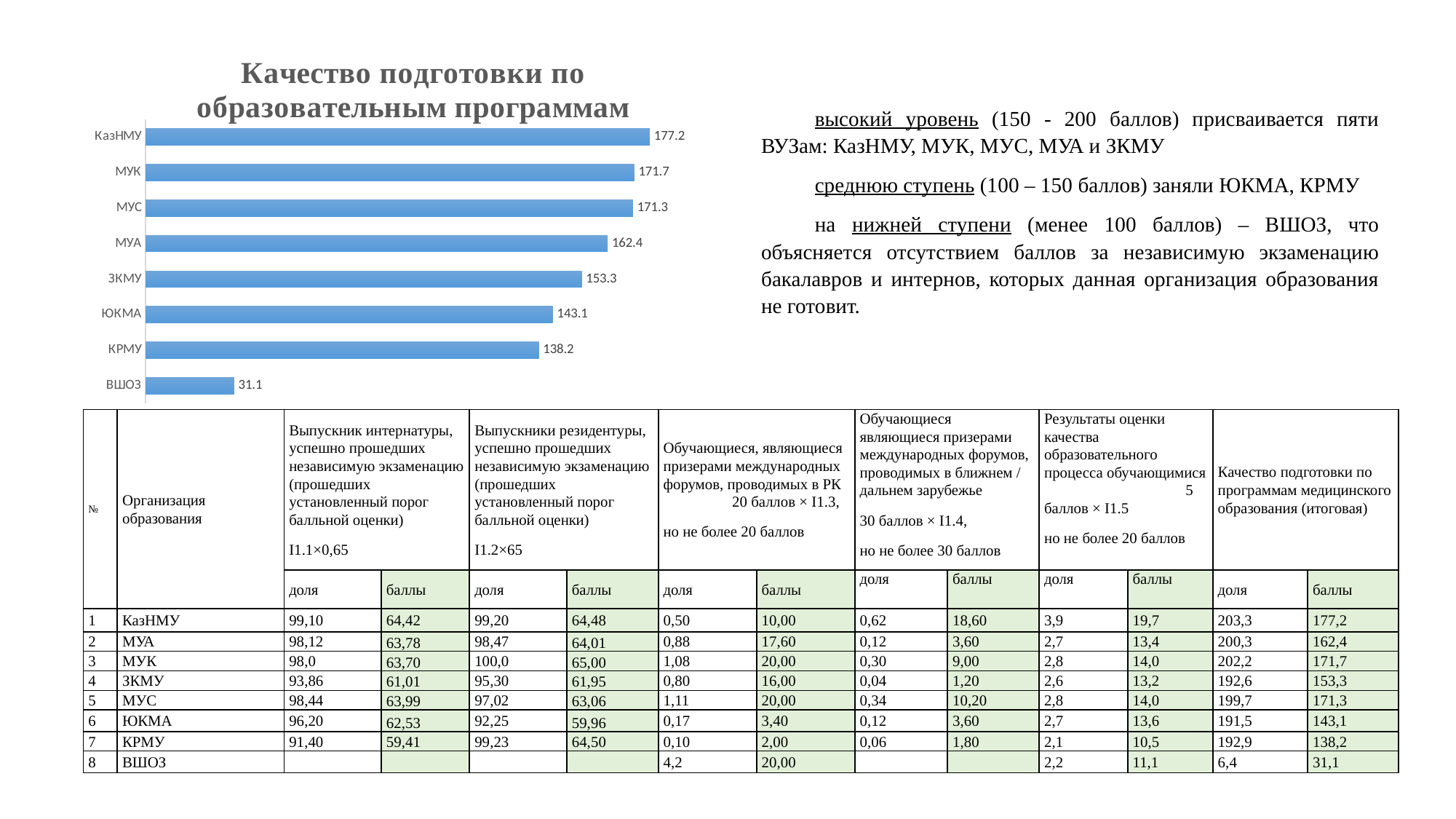
How many organisations are shown in the chart? 8 Which organisation has the highest value in the chart? КазНМУ What is the value for ЗКМУ in the chart? 153.3 Which has a larger value, ЮКМА or КРМУ? ЮКМА What is the difference between the values for КазНМУ and ВШОЗ? 146.1 What is the difference between the values for МУА and ЗКМУ? 9.1 What kind of chart is shown on the slide? bar chart What is the value for КазНМУ in the chart? 177.2 Which has a larger value, МУК or МУА? МУК What is the title of the chart? Качество подготовки по образовательным программам Which organisation has the lowest value in the chart? ВШОЗ What is the value for ВШОЗ in the chart? 31.1